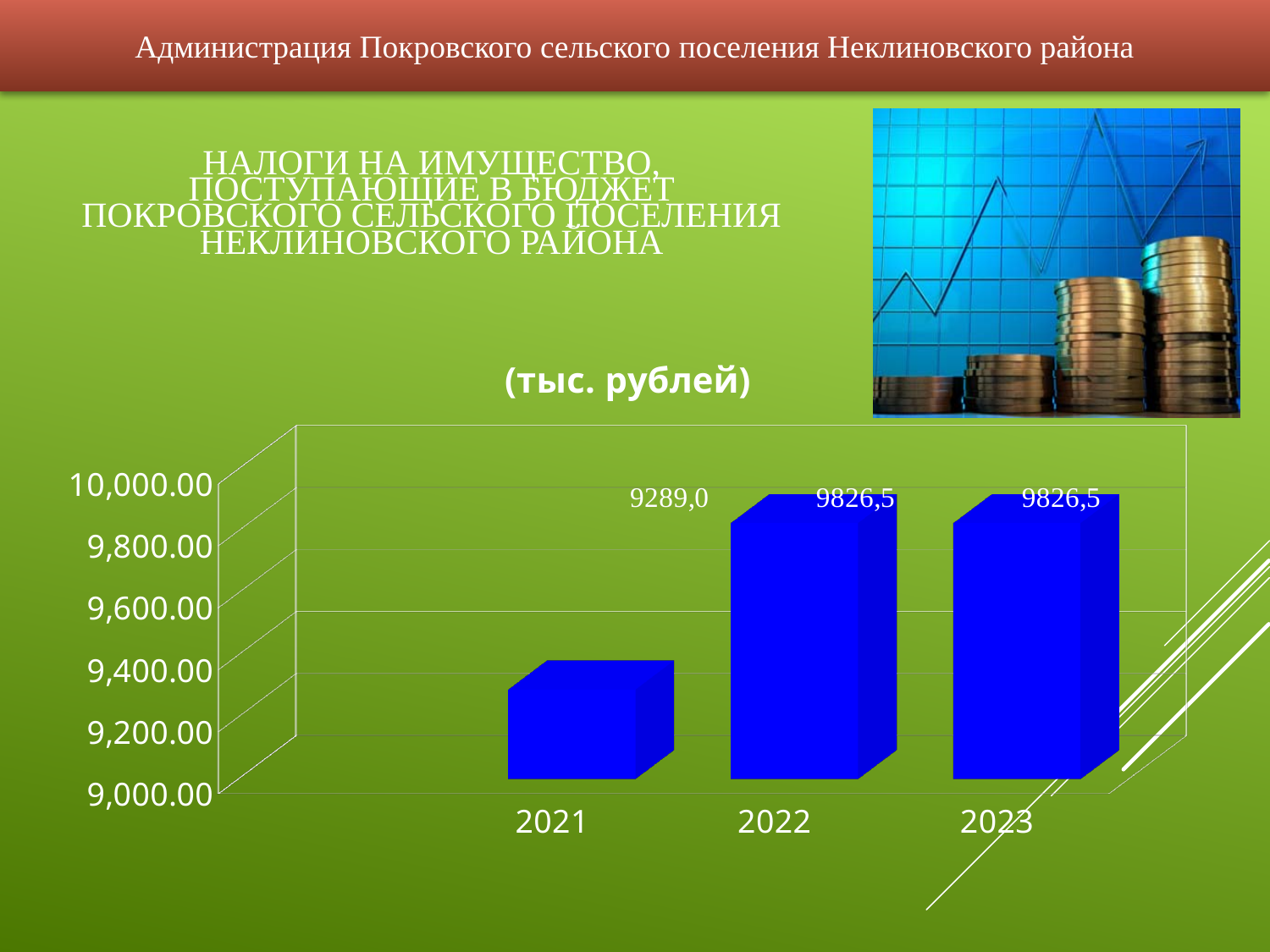
What is the value for 2021? 9289,0 How many years are shown on the x axis? 3 Do the values rise or fall from 2021 to 2023? rise What is the difference between the values for 2022 and 2021? 537,5 Which year has the lowest value? 2021 What kind of chart is shown on the slide? bar chart Is the value for 2021 greater or less than 9,400.00? less What is the value for 2023? 9826,5 What unit is given in the chart title? тыс. рублей Is the value for 2023 greater or less than 9,800.00? greater Which is larger, the value for 2021 or the value for 2022? 2022 What is the value for 2022? 9826,5